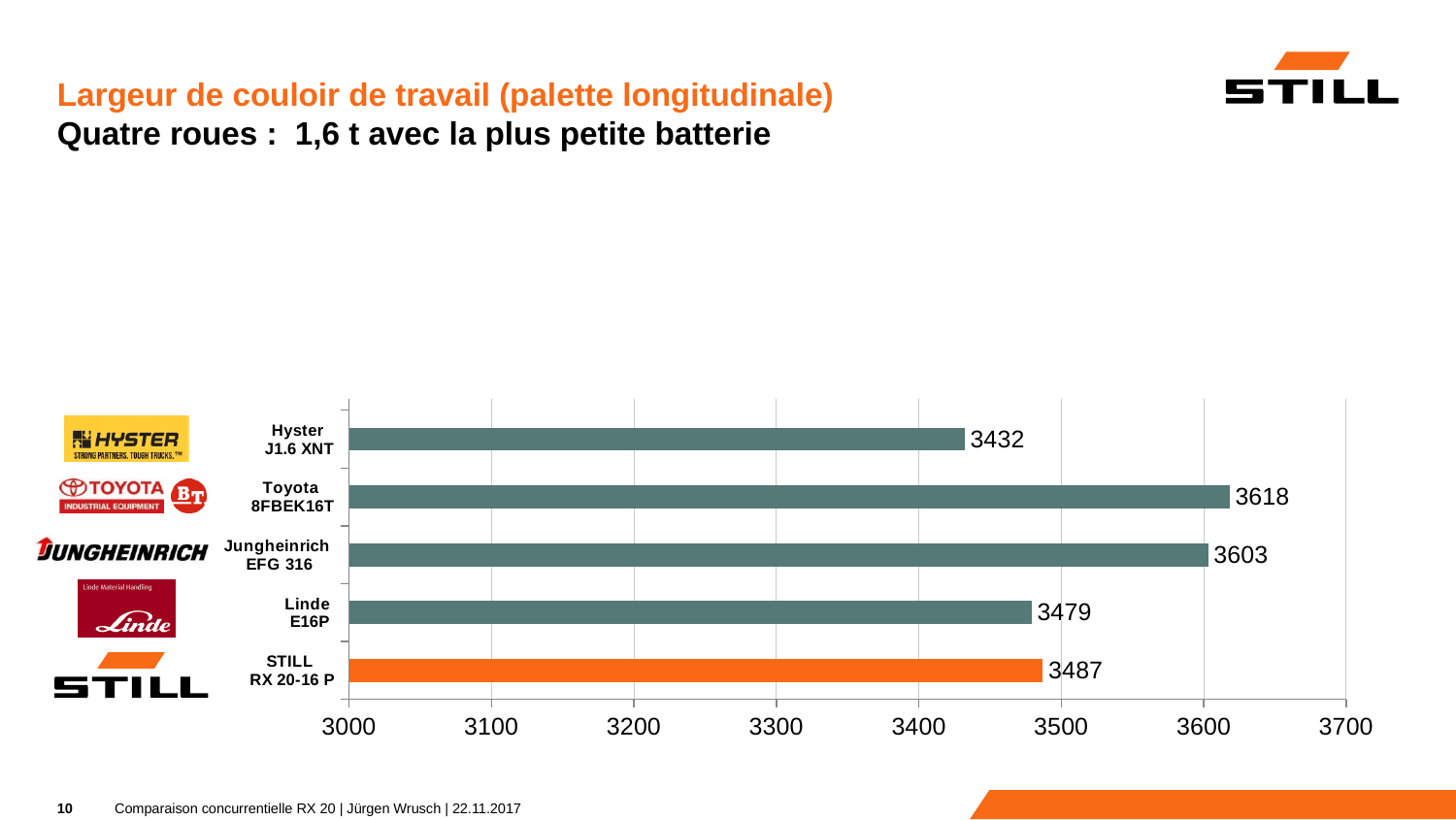
What is the value for Hyster J1.6 XNT? 3432 Which truck has the lowest value? Hyster J1.6 XNT What is the value for Linde E16P? 3479 What is the difference between the values for Toyota 8FBEK16T and Jungheinrich EFG 316? 15 What kind of chart is shown on the slide? bar chart Is the value for Hyster J1.6 XNT greater or less than 3500? less What is the difference between the values for STILL RX 20-16 P and Hyster J1.6 XNT? 55 Which is larger, the value for Jungheinrich EFG 316 or the value for Linde E16P? Jungheinrich EFG 316 Which truck has the highest value? Toyota 8FBEK16T What is the value for Toyota 8FBEK16T? 3618 What is the value for STILL RX 20-16 P? 3487 How many trucks are shown in the chart? 5